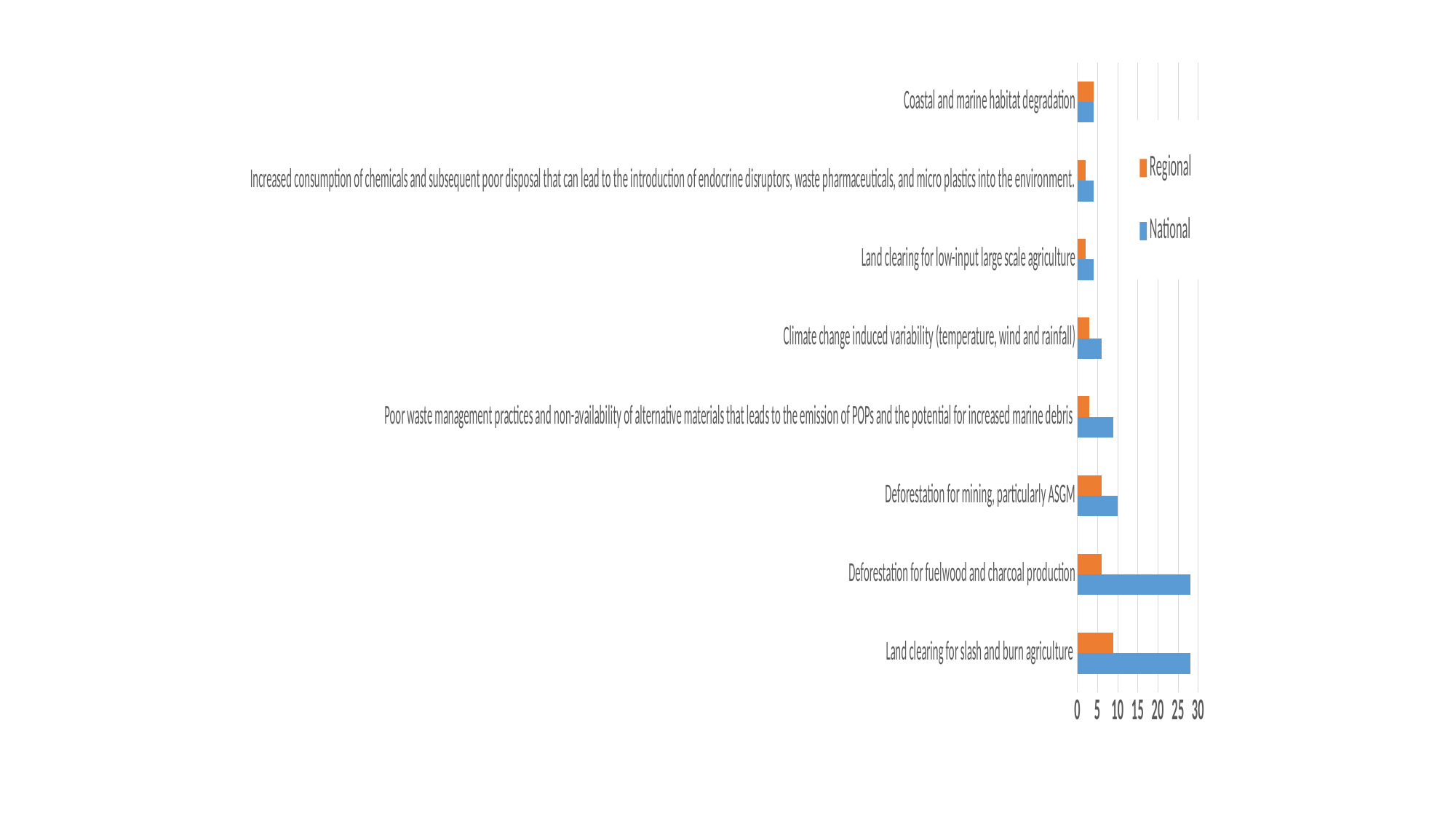
Is the Regional value for Deforestation for mining, particularly ASGM greater or less than 10? less Is the National value for Land clearing for slash and burn agriculture greater or less than 25? greater Which series is shown in blue? National How many categories are plotted on the chart? 8 Which category has the highest Regional value? Land clearing for slash and burn agriculture Is the National value for Coastal and marine habitat degradation greater or less than 10? less Which series is shown in orange? Regional How many series does the legend list? 2 Which is larger for Deforestation for fuelwood and charcoal production, the National value or the Regional value? National What kind of chart is shown on the slide? bar chart Which has the larger National value, Deforestation for mining, particularly ASGM or Land clearing for low-input large scale agriculture? Deforestation for mining, particularly ASGM